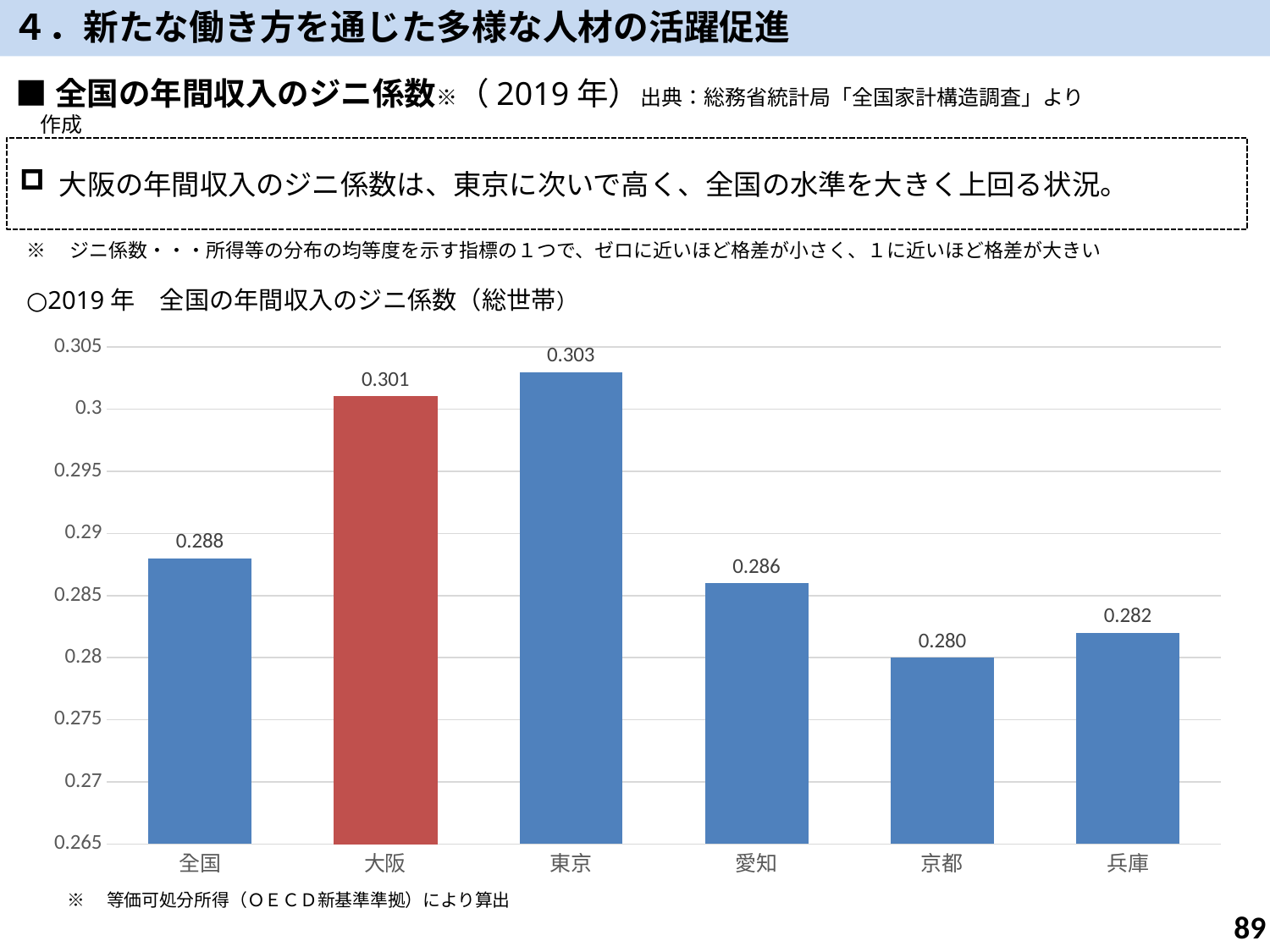
Which is larger, the value for 愛知 or the value for 兵庫? 愛知 How many categories are shown on the x axis? 6 What kind of chart is shown on the slide? bar chart Is the value for 東京 greater or less than 0.3? greater Which bar is coloured red instead of blue? 大阪 What is the Gini coefficient value shown for 大阪? 0.301 What is the difference between the values for 大阪 and 全国? 0.013 Which category has the lowest Gini coefficient? 京都 What is the Gini coefficient value shown for 全国? 0.288 Which category has the highest Gini coefficient? 東京 What is the value shown for 京都? 0.280 What is the difference between the values for 東京 and 大阪? 0.002